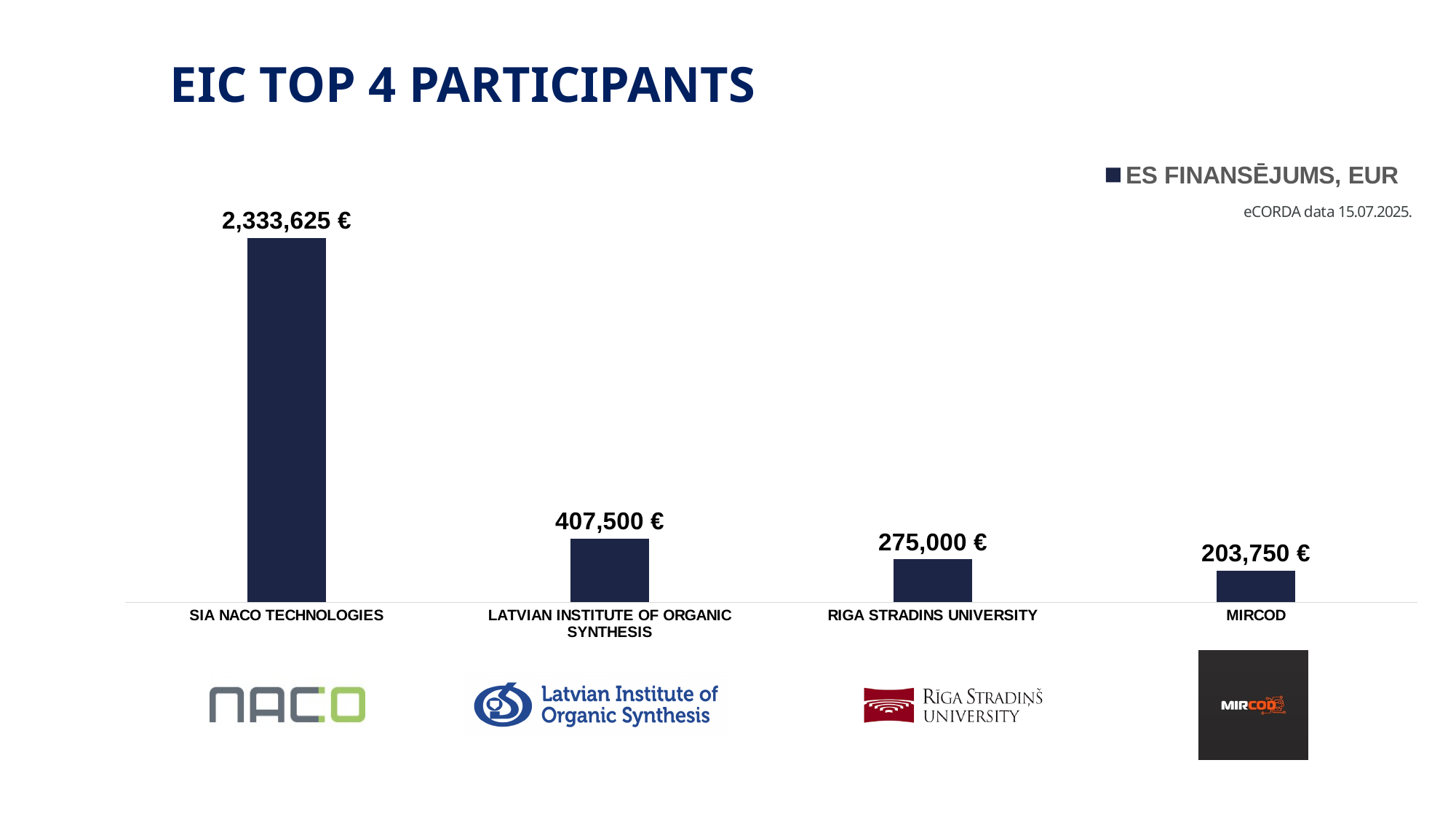
How many participants are shown in the chart? 4 Which has more EU funding, RIGA STRADINS UNIVERSITY or MIRCOD? RIGA STRADINS UNIVERSITY What is the legend entry of the chart? ES FINANSĒJUMS, EUR Which participant has the highest EU funding? SIA NACO TECHNOLOGIES What is the difference between the funding for LATVIAN INSTITUTE OF ORGANIC SYNTHESIS and RIGA STRADINS UNIVERSITY? 132,500 € What is the EU funding value shown for MIRCOD? 203,750 € What is the EU funding value shown for RIGA STRADINS UNIVERSITY? 275,000 € How many series does the legend list? 1 What is the EU funding value shown for SIA NACO TECHNOLOGIES? 2,333,625 € Which participant has the lowest EU funding? MIRCOD What kind of chart is shown on the slide? Bar chart What is the EU funding value shown for LATVIAN INSTITUTE OF ORGANIC SYNTHESIS? 407,500 €